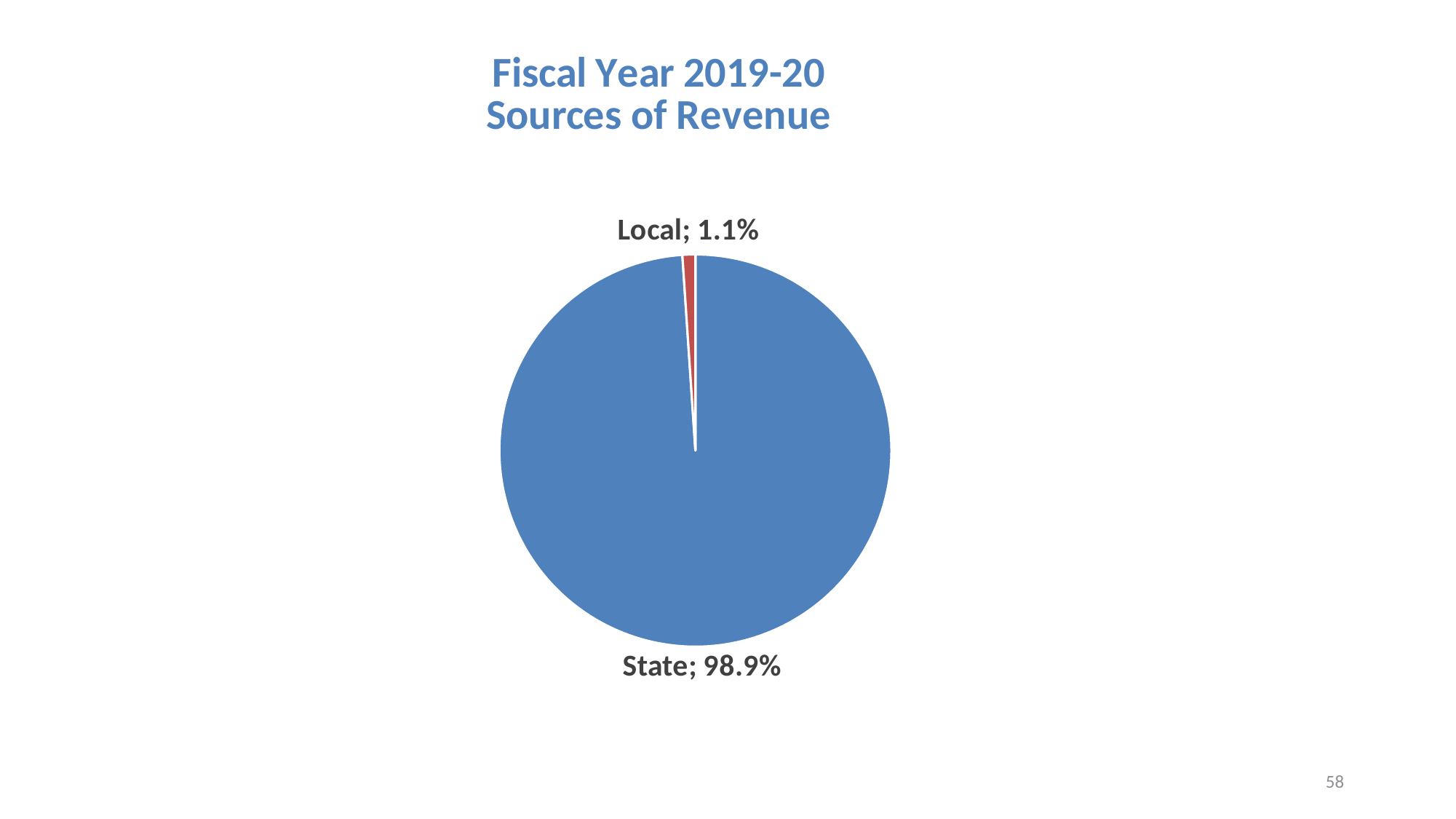
What share of revenue comes from Local? 1.1% What is the title of the chart? Fiscal Year 2019-20 Sources of Revenue How many revenue sources are shown in the pie chart? 2 What is the difference in percentage points between the State and Local shares? 97.8 Which source of revenue has the smallest share? Local What colour is the State slice of the pie? Blue Which source of revenue has the largest share? State Which is larger, the State share or the Local share? State Is the State share greater or less than 90%? greater What kind of chart is shown on the slide? Pie chart What share of revenue comes from State? 98.9%